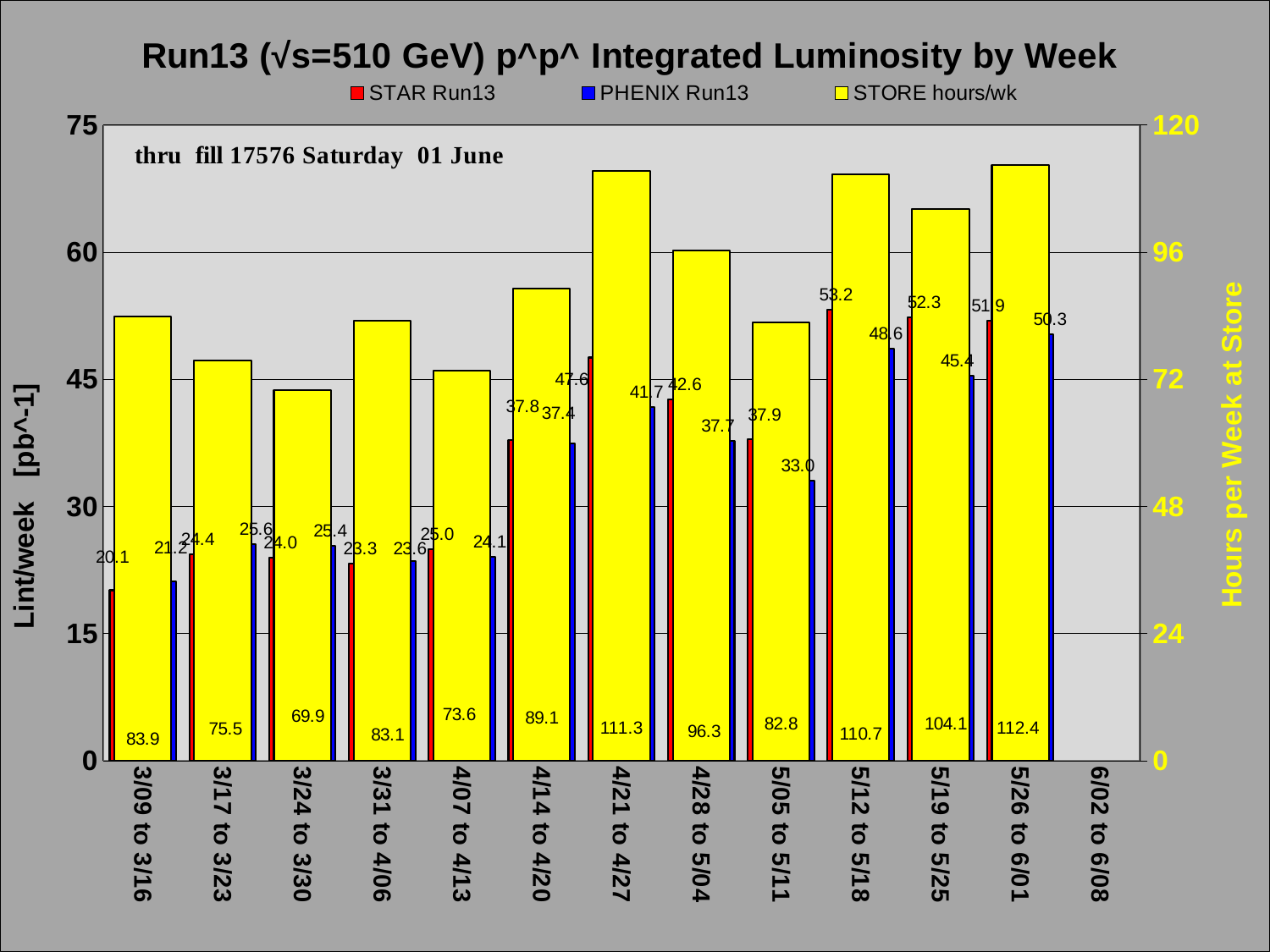
Which week has the highest STORE hours/wk value? 5/26 to 6/01 What is the STAR Run13 value for the week 5/12 to 5/18? 53.2 What is the title of the right-hand vertical axis? Hours per Week at Store What is the PHENIX Run13 value for the week 5/26 to 6/01? 50.3 What is the difference between the highest STORE hours/wk value (112.4) and the lowest (69.9)? 42.5 Which week has the lowest STORE hours/wk value? 3/24 to 3/30 What is the STORE hours/wk value for the week 4/21 to 4/27? 111.3 Which week has the lowest STAR Run13 value? 3/09 to 3/16 What kind of chart is shown on the slide? bar chart How many series does the legend list? 3 How many weekly categories are shown on the x axis? 13 For the week 4/21 to 4/27, which is larger, the STAR Run13 value or the PHENIX Run13 value? STAR Run13